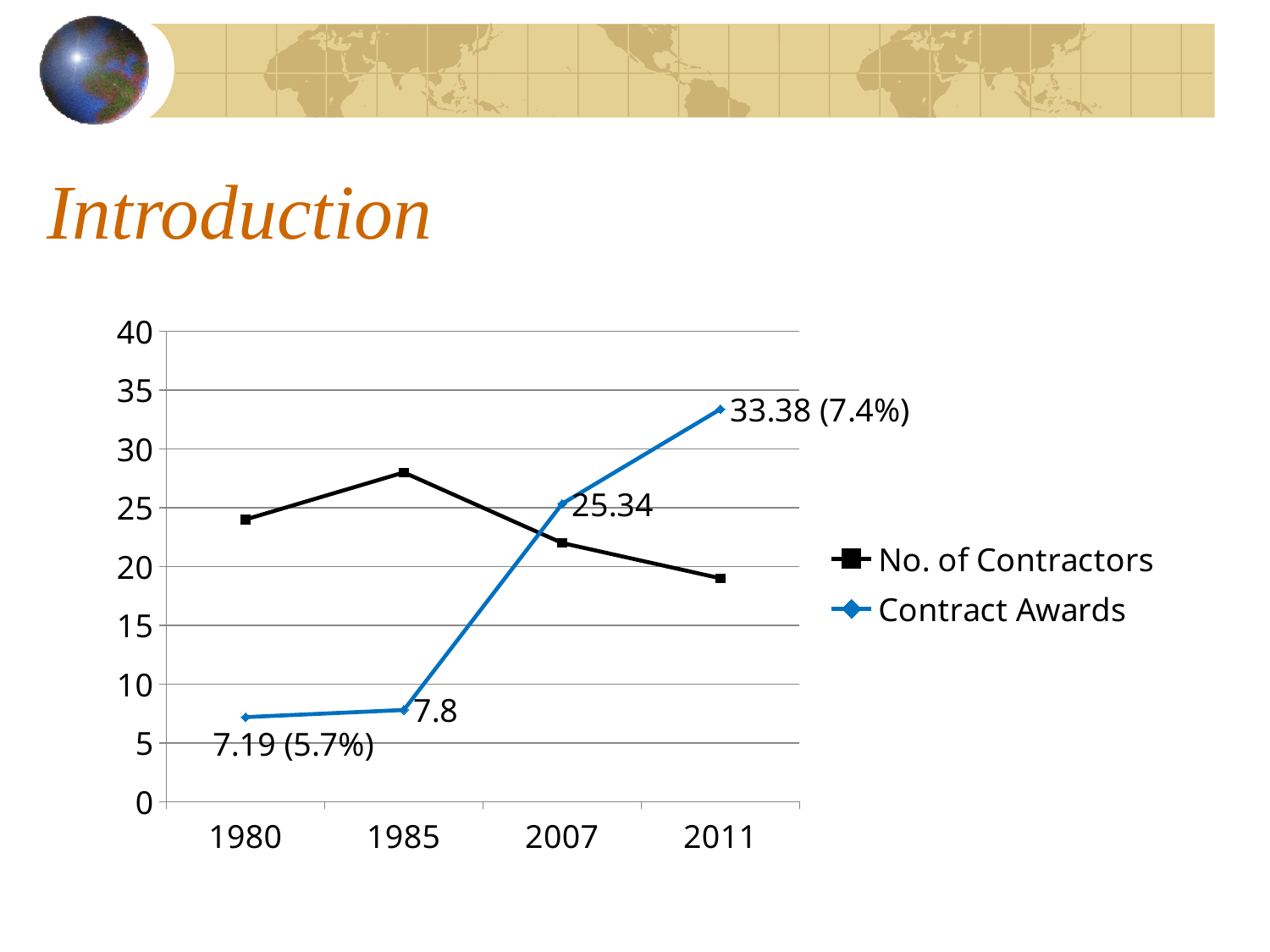
In which year is the No. of Contractors highest? 1985 What is the difference between the Contract Awards values for 2011 and 2007? 8.04 What kind of chart is shown on the slide? Line chart What is the Contract Awards value for 1980? 7.19 (5.7%) In 2011, which series has the larger value, No. of Contractors or Contract Awards? Contract Awards In which year is the Contract Awards value lowest? 1980 Is the No. of Contractors value for 2011 greater or less than 20? less What is the Contract Awards value for 2007? 25.34 In which year is the Contract Awards value highest? 2011 Is the No. of Contractors value for 1985 greater or less than 25? greater What is the Contract Awards value for 2011? 33.38 (7.4%) How many series does the legend list? 2